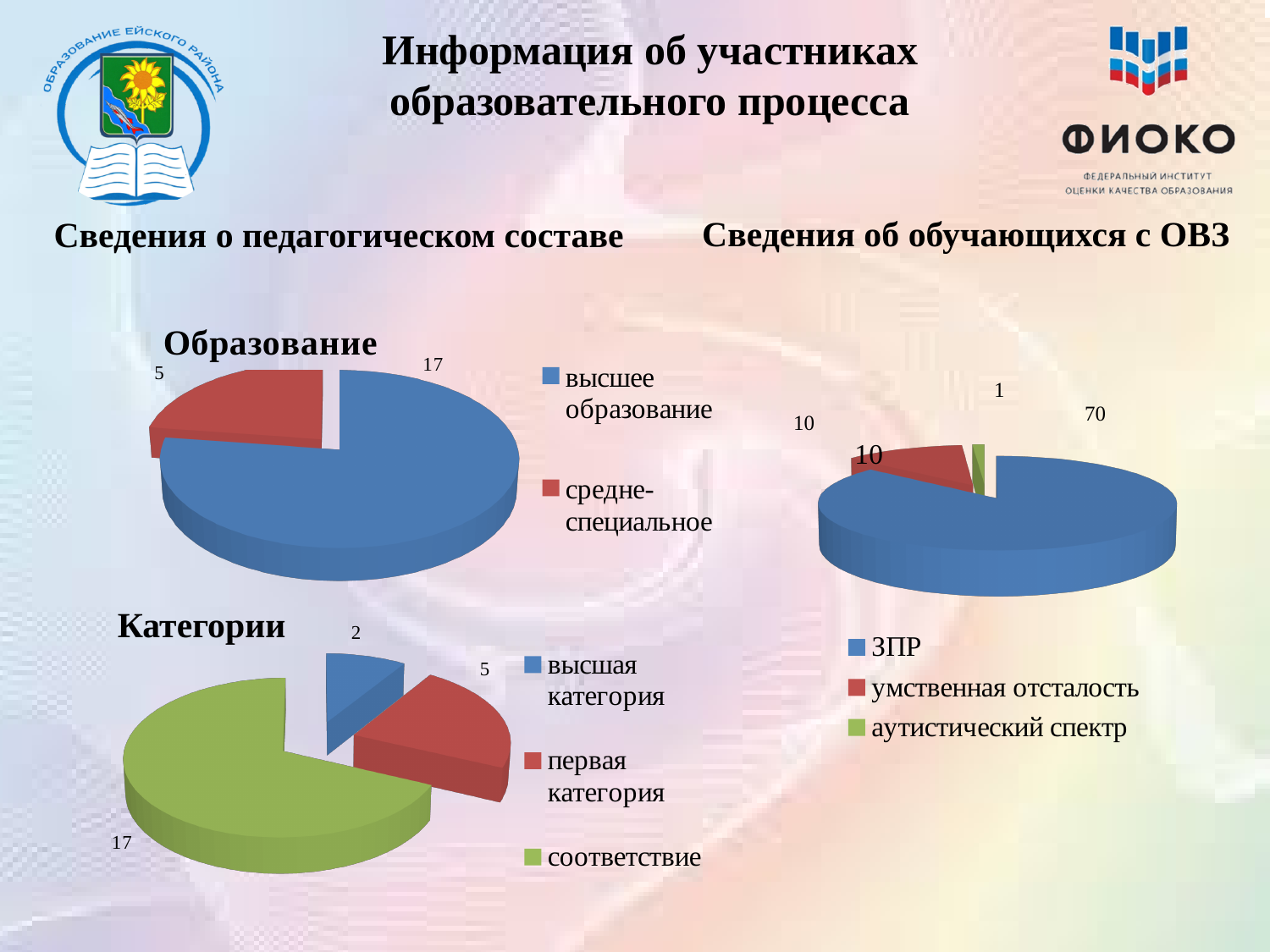
In the "Образование" pie chart, what is the value for "средне-специальное"? 5 In the "Категории" pie chart, what is the value for "первая категория"? 5 In the "Категории" pie chart, which category has the smallest value? высшая категория In the "Сведения об обучающихся с ОВЗ" pie chart, what is the value for "ЗПР"? 70 In the "Категории" pie chart, which category has the largest value? соответствие In the "Образование" pie chart, what is the difference between the values for "высшее образование" and "средне-специальное"? 12 In the "Образование" pie chart, what is the value for "высшее образование"? 17 How many categories does the "Категории" pie chart show? 3 What type of chart is the "Образование" chart? pie chart In the "Сведения об обучающихся с ОВЗ" pie chart, what is the value for "аутистический спектр"? 1 How many series does the legend of the "Сведения об обучающихся с ОВЗ" chart list? 3 In the "Сведения об обучающихся с ОВЗ" pie chart, which is larger: "умственная отсталость" or "аутистический спектр"? умственная отсталость